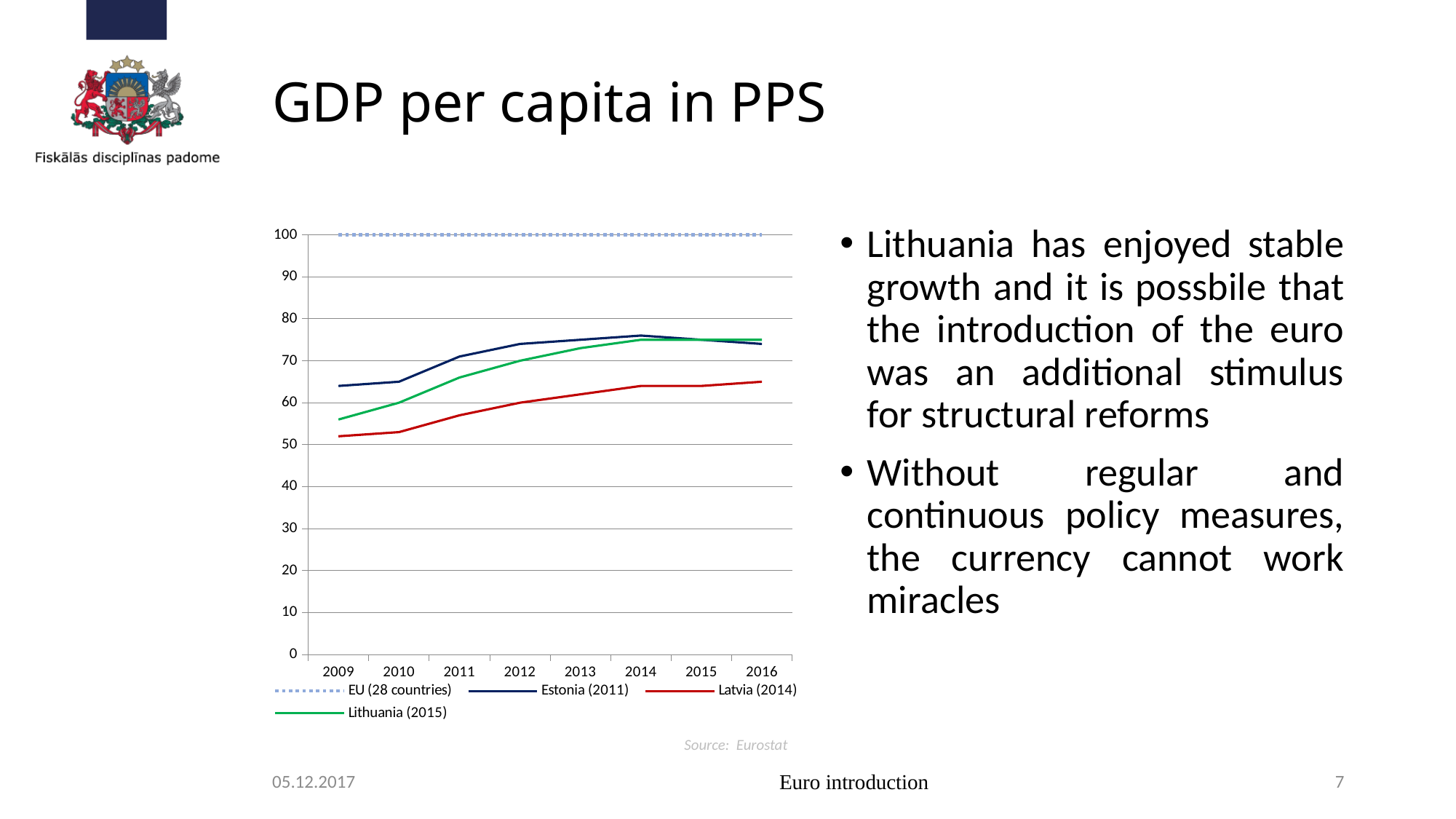
Does the Latvia (2014) series rise or fall from 2009 to 2016? rise Which series has the lowest value in 2009? Latvia (2014) Is the value for Estonia (2011) in 2014 greater or less than 70? greater Is the value for Lithuania (2015) in 2009 greater or less than 60? less What kind of chart is shown on the slide? line chart In 2012, which is higher: Estonia (2011) or Latvia (2014)? Estonia (2011) How many years are shown on the x axis of the chart? 8 Which series has the highest value in 2016? EU (28 countries) Is the value for Latvia (2014) in 2009 greater or less than 50? greater What is the source cited below the chart? Eurostat What is the value of the EU (28 countries) series in 2012? 100 How many series does the chart legend list? 4